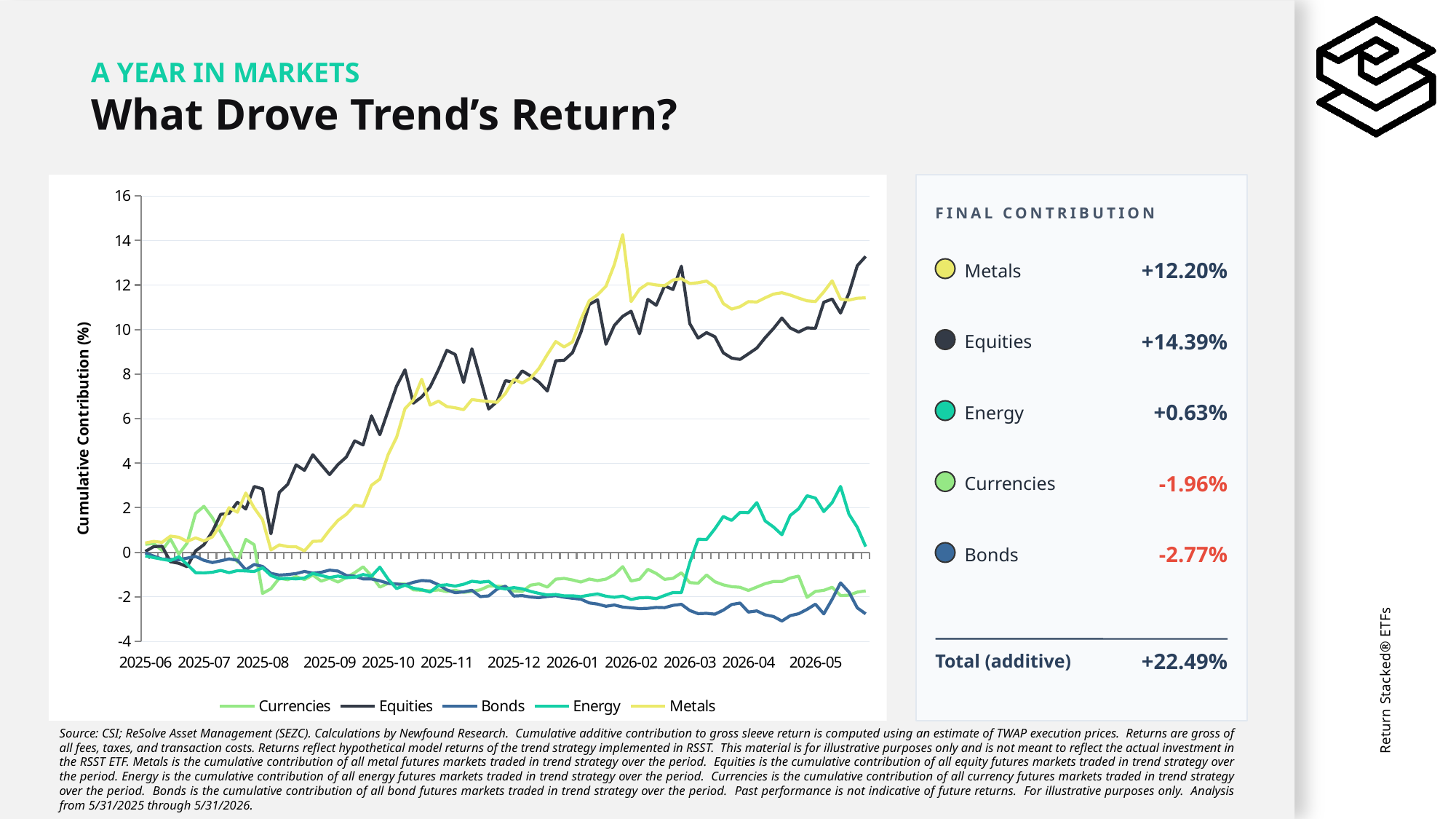
What is the final contribution of Bonds? -2.77% What is the difference between the final contributions of Equities and Metals? 2.19% Which sector has the highest final contribution? Equities What is the final contribution of Currencies? -1.96% Which sector has the lowest final contribution? Bonds What is the final contribution of Equities? +14.39% What is the final contribution of Metals? +12.20% How many series does the chart legend list? 5 What is the total (additive) final contribution across all sectors? +22.49% Is the lowest point of the Bonds line greater or less than -2? less What kind of chart is shown on the slide? line chart What is the label on the y axis of the chart? Cumulative Contribution (%)